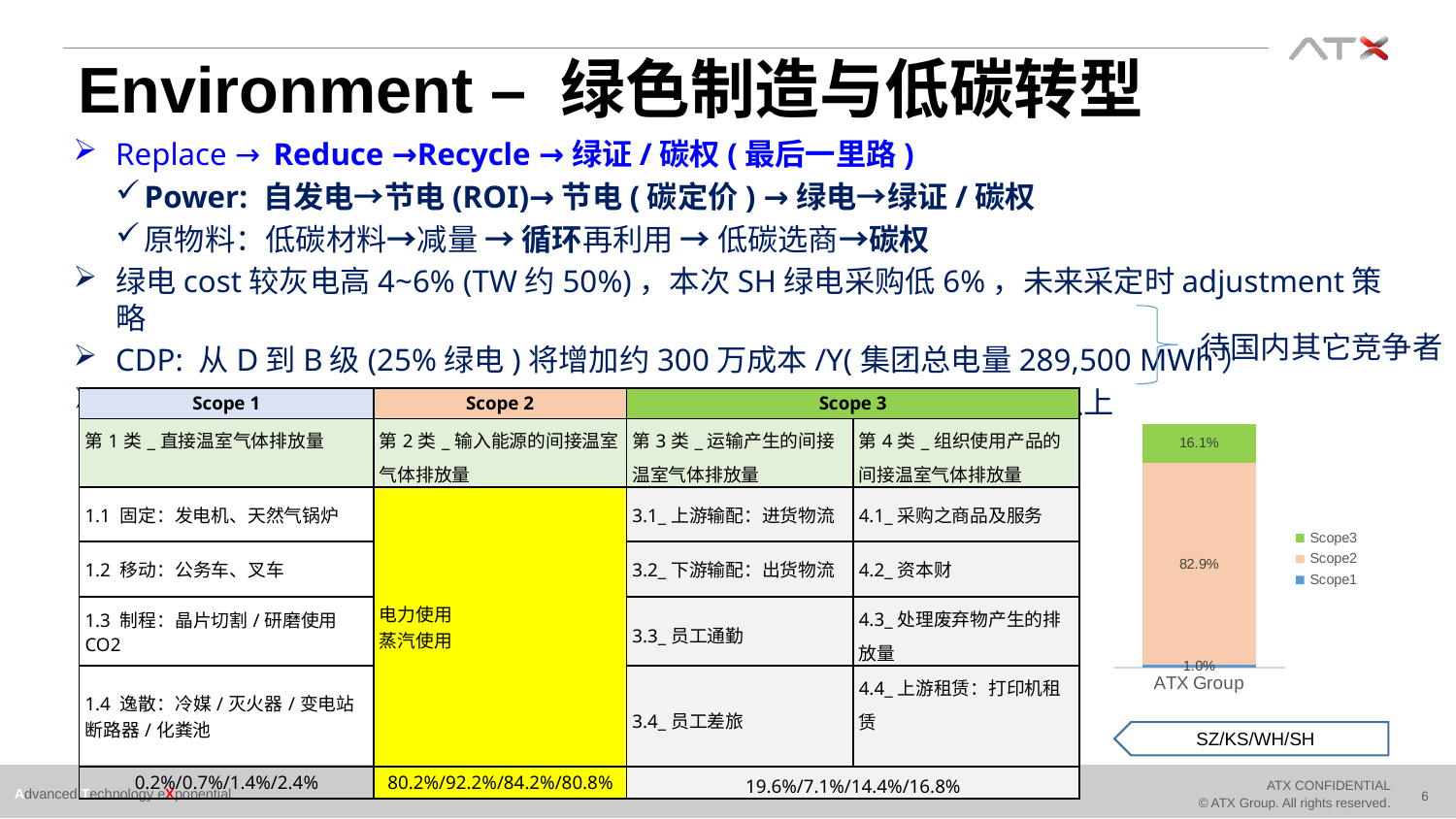
How many bars (categories) are plotted in the stacked bar chart? 1 In the stacked bar chart, what is the value for Scope2? 82.9% In the stacked bar chart, which scope has the smallest share? Scope1 In the stacked bar chart, which scope has the largest share? Scope2 In the stacked bar chart, what is the value for Scope3? 16.1% What type of chart is shown on the right side of the slide? stacked bar chart In the stacked bar chart, what is the value for Scope1? 1.0% What is the category label under the bar in the stacked bar chart? ATX Group In the stacked bar chart, which is larger, Scope3 or Scope1? Scope3 How many series does the legend of the stacked bar chart list? 3 In the stacked bar chart, what is the difference between the Scope2 and Scope3 values? 66.8% What is the total of the stacked bar for ATX Group? 100.0%